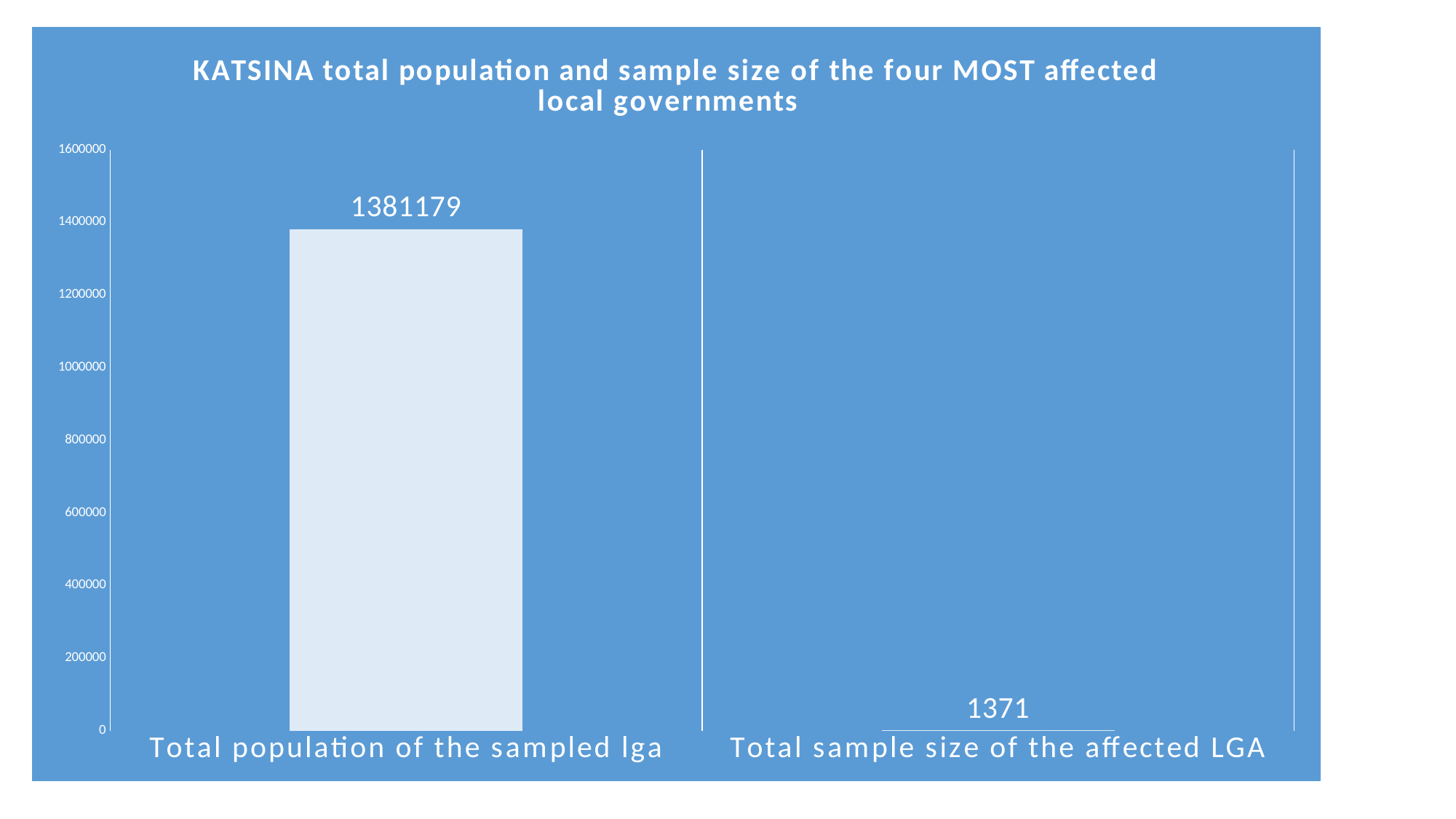
What is the difference between the total population of the sampled lga and the total sample size of the affected LGA? 1379808 What is the title of the chart? KATSINA total population and sample size of the four MOST affected local governments What is the value for Total sample size of the affected LGA? 1371 Is the value for Total sample size of the affected LGA greater or less than 200000? less Which is larger, the total population of the sampled lga or the total sample size of the affected LGA? Total population of the sampled lga How many categories are shown on the x axis? 2 Which category has the highest value? Total population of the sampled lga Is the value for Total population of the sampled lga greater or less than 1200000? greater Which category has the lowest value? Total sample size of the affected LGA What is the value for Total population of the sampled lga? 1381179 What is the maximum value shown on the vertical axis? 1600000 What kind of chart is shown on the slide? Bar chart